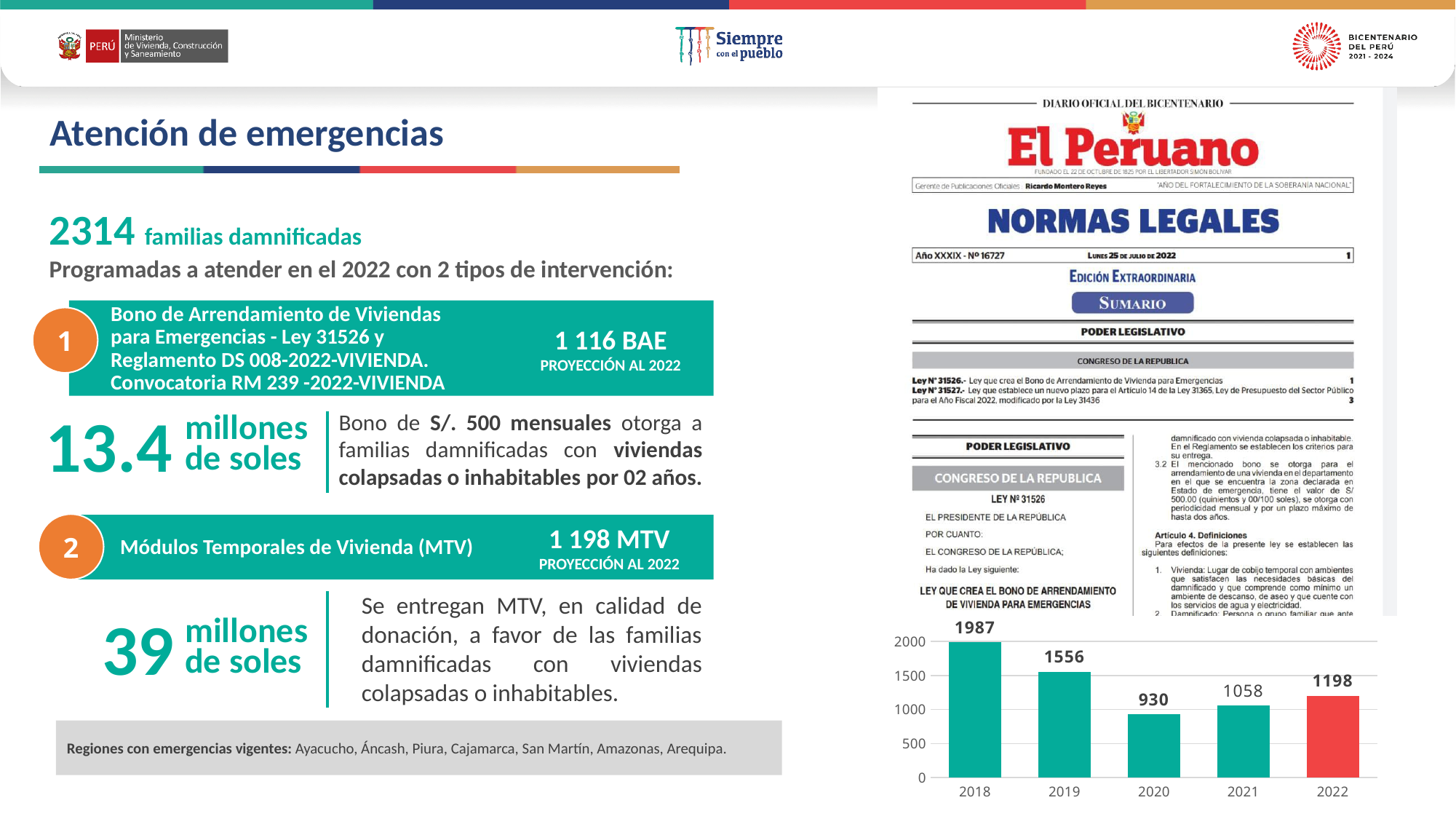
Is the value for 2020 in the bar chart greater or less than 1000? less Which year has the lowest value in the bar chart? 2020 What is the value shown for 2018 in the bar chart? 1987 Which is larger in the bar chart, the value for 2019 or the value for 2021? 2019 What kind of chart is shown at the bottom right of the slide? bar chart Which year has the highest value in the bar chart? 2018 What is the difference between the values for 2018 and 2019 in the bar chart? 431 How many years are shown on the x axis of the bar chart? 5 What is the value shown for 2022 in the bar chart? 1198 What is the value shown for 2020 in the bar chart? 930 What is the difference between the values for 2022 and 2021 in the bar chart? 140 Which bar in the chart is coloured red instead of teal? 2022